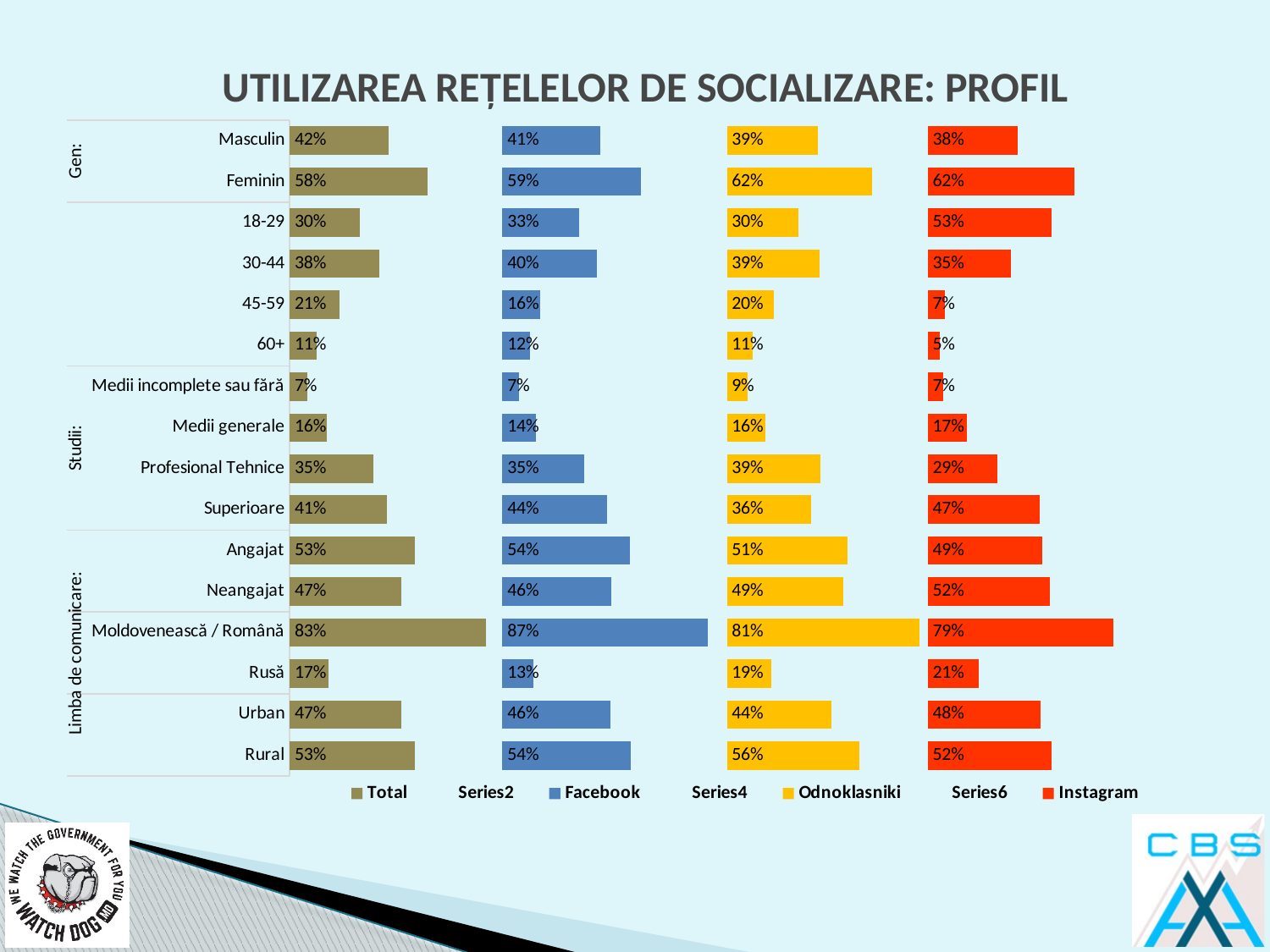
What is the difference between the Odnoklasniki and Instagram values for 45-59? 13% What kind of chart is shown on the slide? Bar chart Which category has the lowest Instagram value? 60+ What is the Total value for Feminin? 58% Which is larger for Superioare: the Facebook value or the Odnoklasniki value? Facebook What is the Instagram value for the 18-29 category? 53% What is the Odnoklasniki value for Rural? 56% Which category has the highest Total value? Moldovenească / Română What is the Facebook value for Moldovenească / Română? 87% How many entries does the legend list? 7 How many categories are shown on the vertical axis? 16 What is the title of the chart? UTILIZAREA REȚELELOR DE SOCIALIZARE: PROFIL